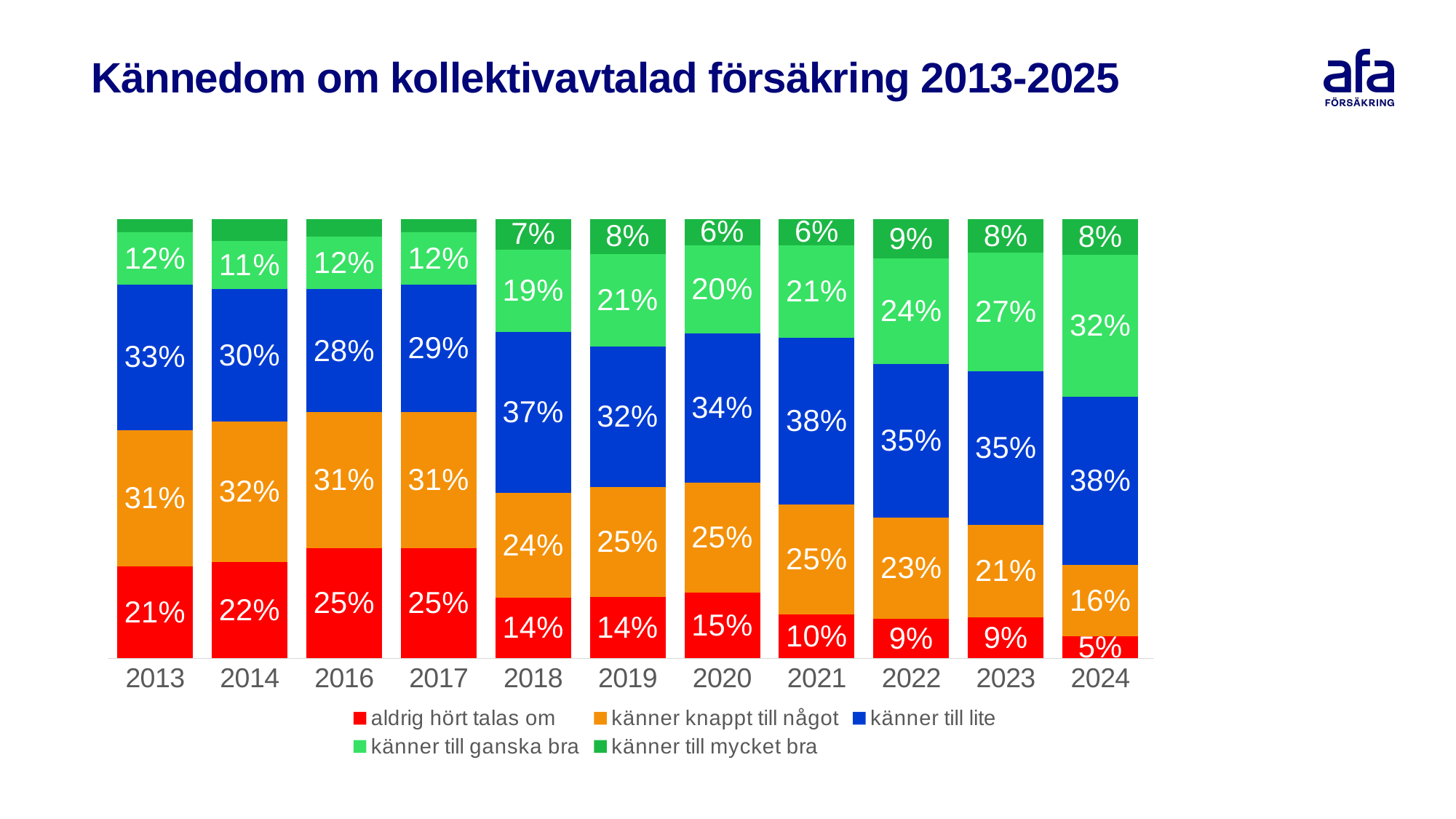
What is the value for "känner till ganska bra" in 2024? 32% Which year has the lowest value for "aldrig hört talas om"? 2024 What is the value for "aldrig hört talas om" in 2024? 5% How many years are shown on the x axis? 11 What is the value for "känner till mycket bra" in 2022? 9% Does the value for "aldrig hört talas om" generally rise or fall from 2013 to 2024? Fall What is the difference between the "aldrig hört talas om" values for 2013 and 2024? 16 percentage points Which year has the highest value for "känner till ganska bra"? 2024 What kind of chart is shown on the slide? Stacked bar chart What is the value for "känner till lite" in 2021? 38% Which is larger, the "känner knappt till något" value for 2014 or for 2024? 2014 How many series does the legend list? 5